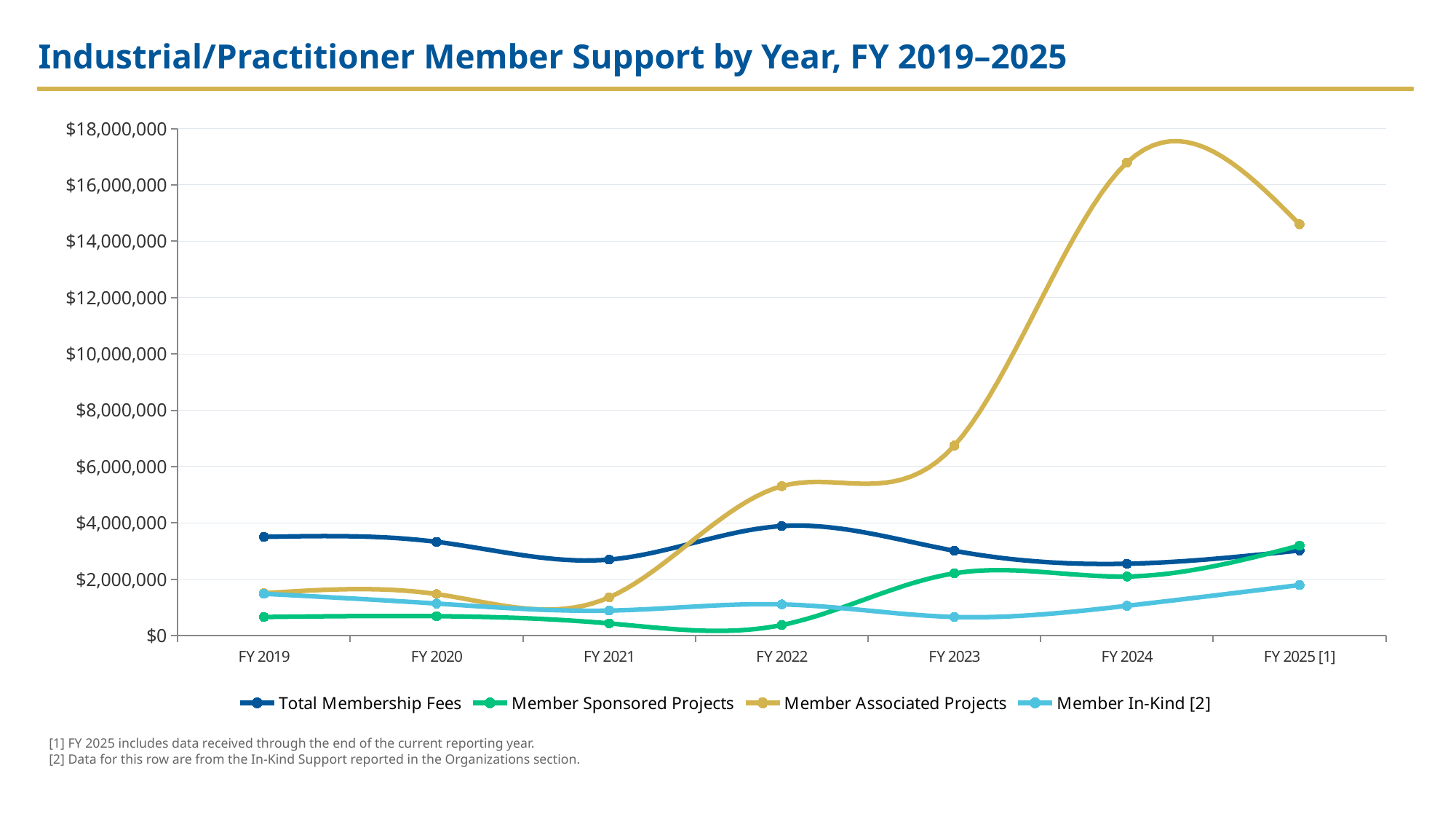
In which fiscal year does Total Membership Fees reach its highest value? FY 2022 How many fiscal years are plotted along the x axis? 7 Does the Member Associated Projects line rise or fall from FY 2021 to FY 2024? Rise Is the value for Member Associated Projects in FY 2025 greater or less than $14,000,000? greater Is the value for Member Sponsored Projects in FY 2022 greater or less than $2,000,000? less Is the value for Member In-Kind in FY 2025 greater or less than $2,000,000? less In FY 2023, which is larger: Member Associated Projects or Total Membership Fees? Member Associated Projects In FY 2019, which is larger: Total Membership Fees or Member Sponsored Projects? Total Membership Fees What kind of chart is shown on the slide? Line chart How many series does the legend list? 4 In which fiscal year does Member Associated Projects reach its highest value? FY 2024